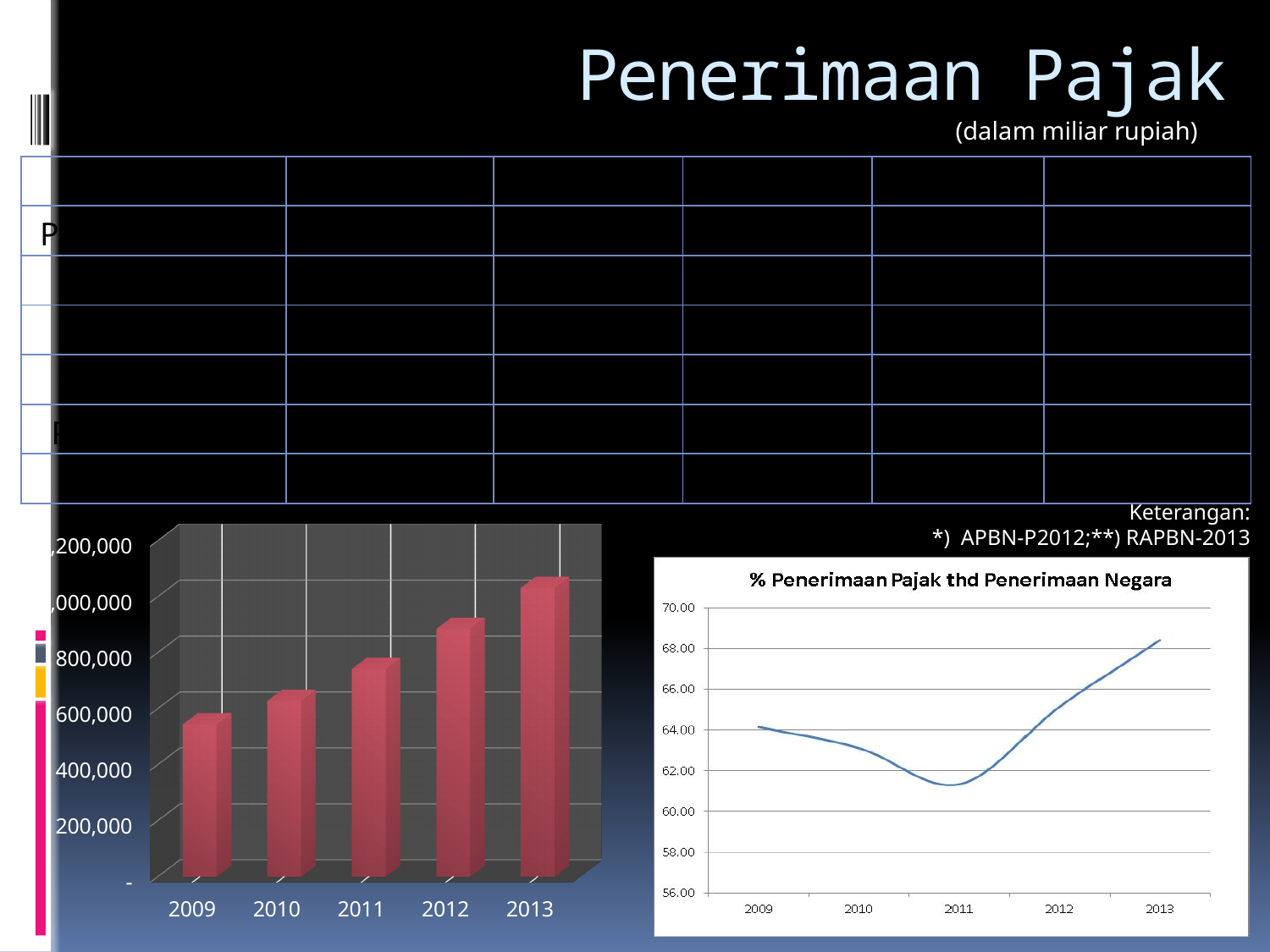
In the bar chart at the bottom left, do the values rise or fall from 2009 to 2013? rise In the bar chart at the bottom left, which year has the shortest bar? 2009 What kind of chart is the chart at the bottom left of the slide? bar chart In the chart '% Penerimaan Pajak thd Penerimaan Negara', which year has the lowest value? 2011 What kind of chart is the chart titled '% Penerimaan Pajak thd Penerimaan Negara'? line chart In the chart '% Penerimaan Pajak thd Penerimaan Negara', is the value for 2011 greater or less than 62.00? less In the bar chart at the bottom left, which year has the tallest bar? 2013 In the chart '% Penerimaan Pajak thd Penerimaan Negara', which year has the highest value? 2013 In the bar chart at the bottom left, is the value for 2012 greater or less than 800,000? greater In the chart '% Penerimaan Pajak thd Penerimaan Negara', which is larger, the value for 2010 or the value for 2012? 2012 In the bar chart at the bottom left, how many years are shown on the x axis? 5